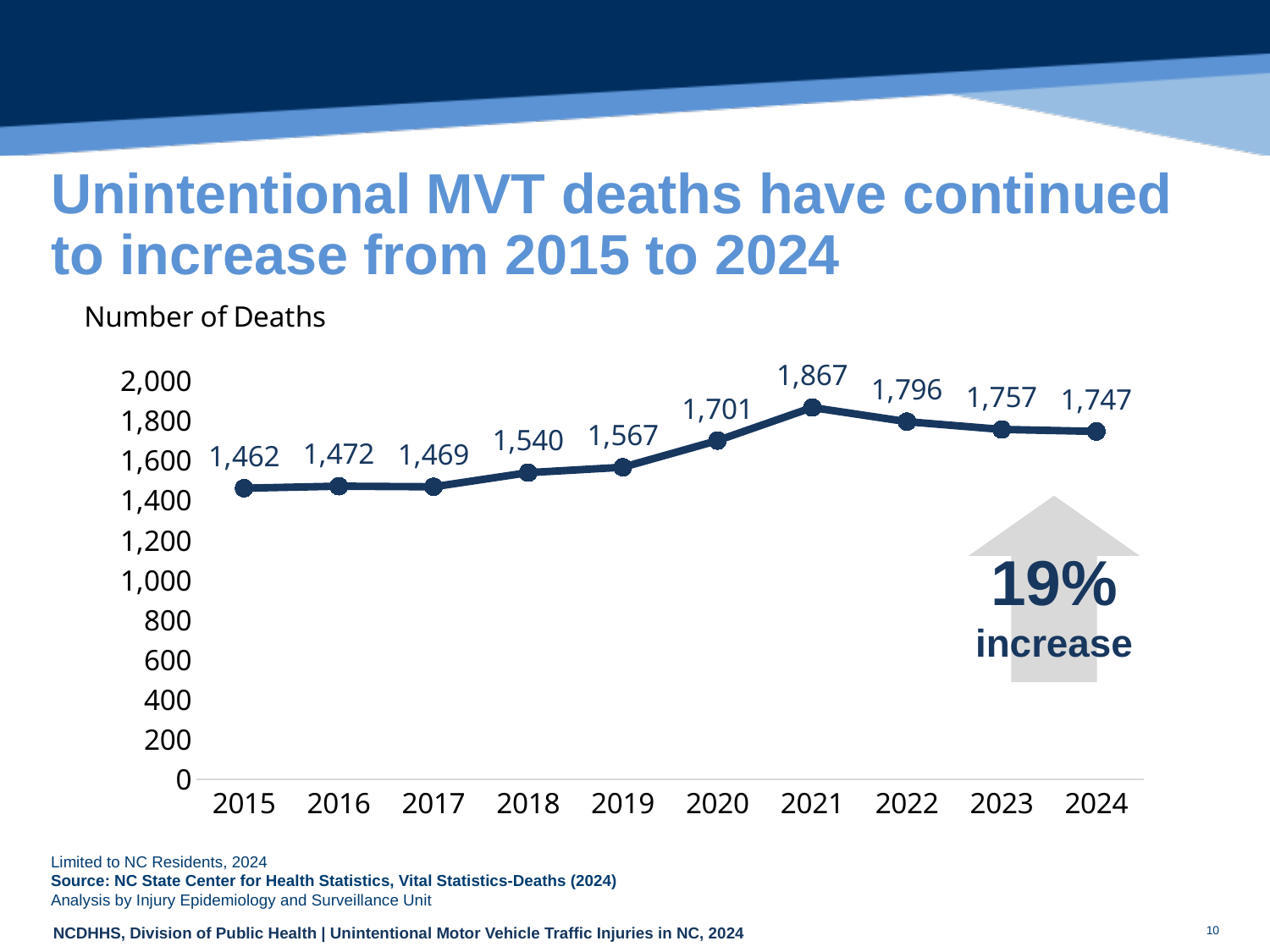
What is the difference in deaths between 2024 and 2015? 285 What is the number of deaths in 2024? 1,747 What is the difference in deaths between 2021 and 2020? 166 Which year had more deaths, 2018 or 2019? 2019 Which year has the highest number of deaths? 2021 What is the number of deaths in 2021? 1,867 What percentage increase is highlighted in the arrow on the chart? 19% What kind of chart is shown on the slide? line chart What is the number of deaths in 2015? 1,462 How many years are plotted on the chart? 10 Which year has the lowest number of deaths? 2015 Is the value for 2020 greater or less than 1,600? greater